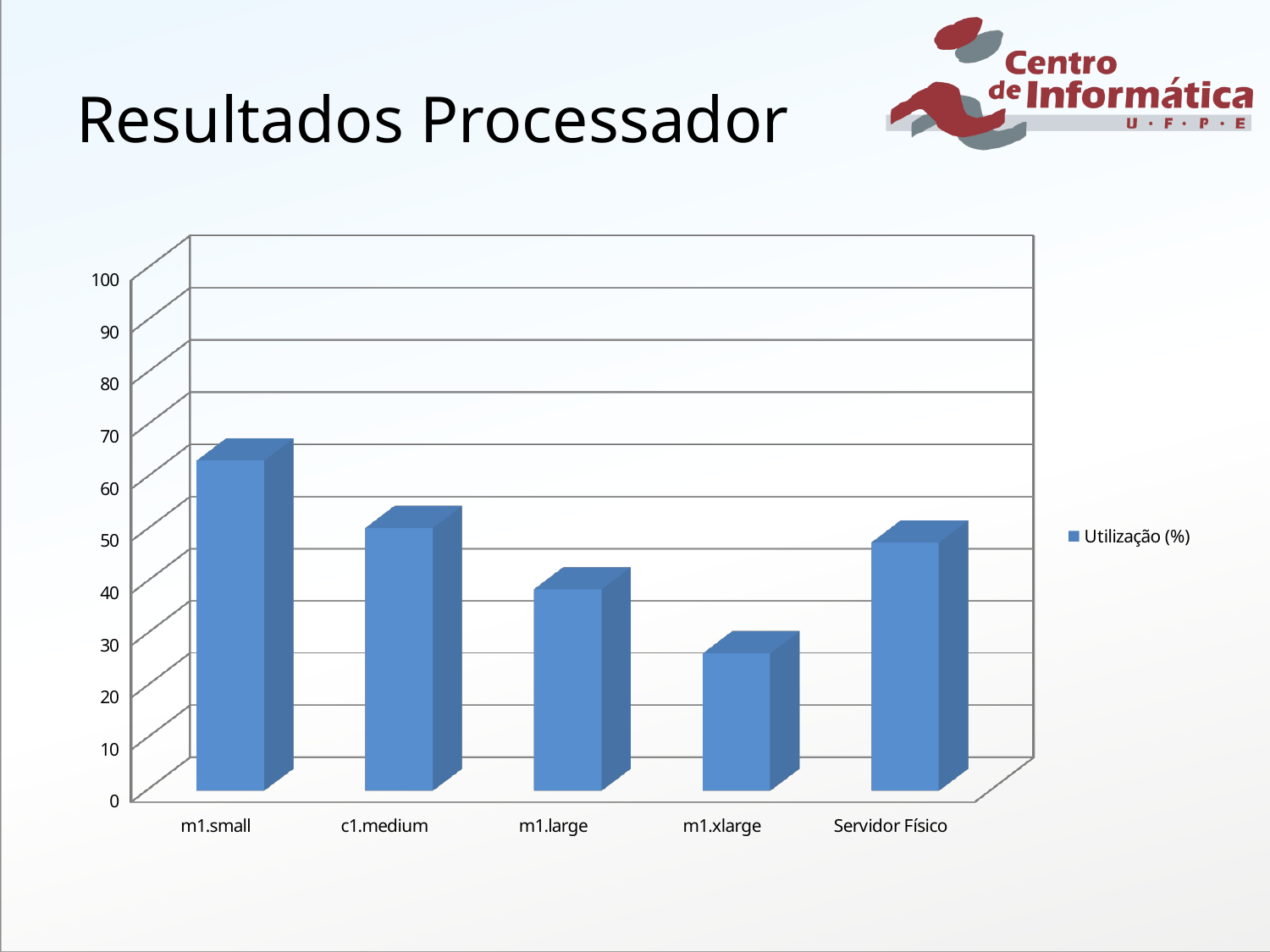
Is the value for m1.large greater or less than 50? less What kind of chart is shown on the slide? bar chart What is the name of the series shown in the chart's legend? Utilização (%) How many categories are shown on the x axis of the chart? 5 Which category has the lowest utilization value? m1.xlarge Which has a larger value, m1.small or m1.xlarge? m1.small Is the value for m1.small greater or less than 50? greater How many series does the chart's legend list? 1 Which has a larger value, m1.large or Servidor Físico? Servidor Físico Which has a larger value, c1.medium or m1.large? c1.medium Which category has the highest utilization value? m1.small Is the value for m1.xlarge greater or less than 40? less